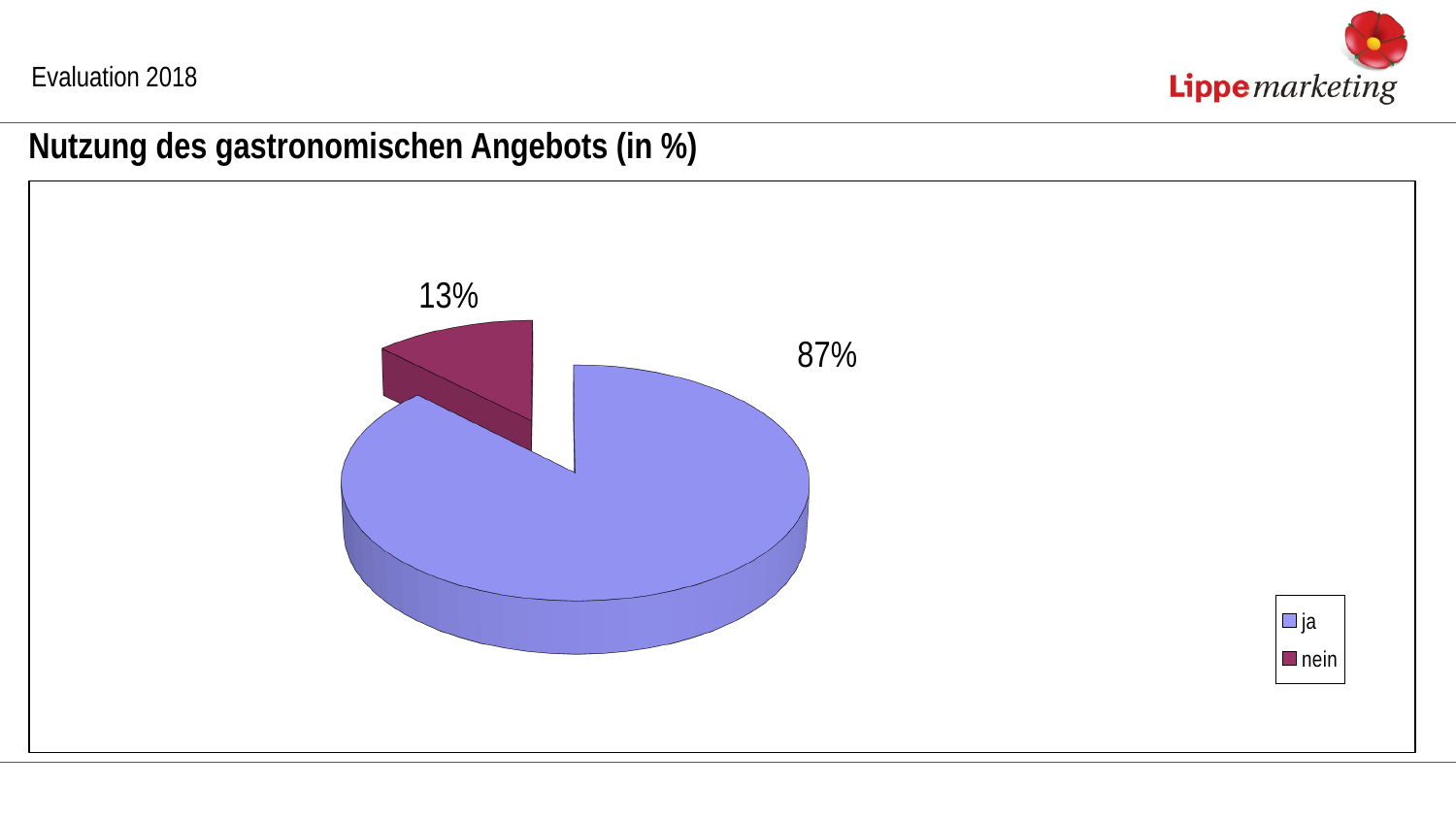
What is the title of the chart? Nutzung des gastronomischen Angebots (in %) What is the difference in percentage points between "ja" and "nein"? 74 Which category has the largest share of the pie? ja What kind of chart is shown on the slide? pie chart What share of the pie does the "nein" slice represent? 13% How many categories does the pie chart show? 2 Which category has the smallest share of the pie? nein What percentage of respondents answered "nein"? 13% Which colour represents the "nein" category in the chart? dark red Which is larger, the share for "ja" or the share for "nein"? ja What percentage of respondents answered "ja"? 87% How many entries does the legend list? 2